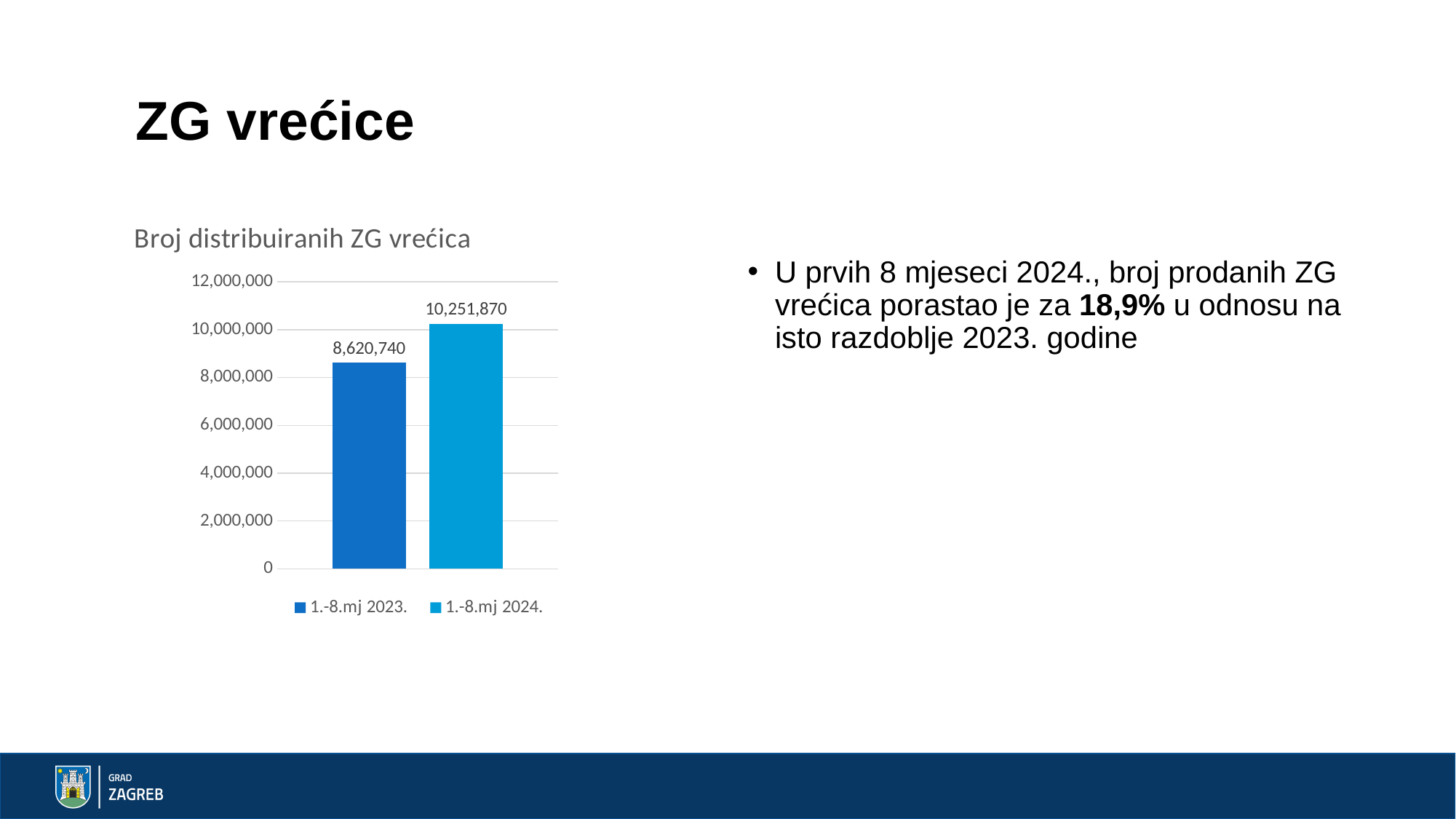
Which series has the lowest value in the chart? 1.-8.mj 2023. How many series does the legend list? 2 What is the title of the chart? Broj distribuiranih ZG vrećica Is the value for 1.-8.mj 2023. greater or less than 10,000,000? less What is the difference between the values for 1.-8.mj 2024. and 1.-8.mj 2023.? 1,631,130 Is the value for 1.-8.mj 2024. greater or less than 10,000,000? greater What is the value for 1.-8.mj 2024. in the chart? 10,251,870 What is the value for 1.-8.mj 2023. in the chart? 8,620,740 Which series has the highest value in the chart? 1.-8.mj 2024. What kind of chart is shown on the slide? Bar chart How many bars are plotted in the chart? 2 Which series has the higher value, 1.-8.mj 2023. or 1.-8.mj 2024.? 1.-8.mj 2024.